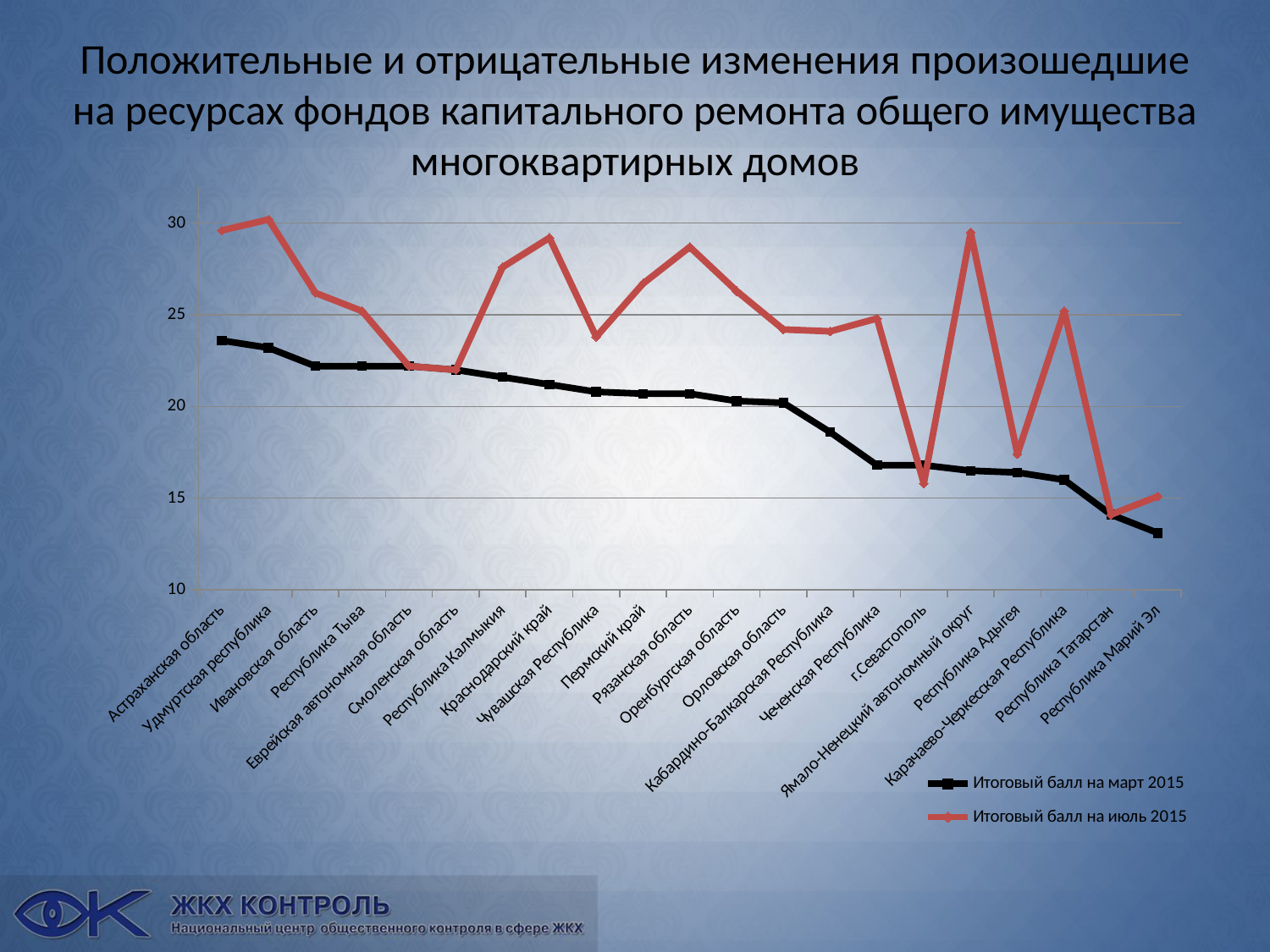
Is the value for Краснодарский край in the series "Итоговый балл на июль 2015" greater or less than 25? greater How many regions are plotted along the x axis? 21 Is the value for Чеченская Республика in the series "Итоговый балл на март 2015" greater or less than 20? less Does the series "Итоговый балл на март 2015" rise or fall from left to right along the x axis? fall Which region has the lowest value for "Итоговый балл на июль 2015"? Республика Татарстан What kind of chart is shown on the slide? line chart What colour is the line for "Итоговый балл на июль 2015"? red How many series does the legend list? 2 For Республика Марий Эл, which series has the larger value: "Итоговый балл на март 2015" or "Итоговый балл на июль 2015"? Итоговый балл на июль 2015 Is the value for г.Севастополь in the series "Итоговый балл на июль 2015" greater or less than 20? less Which region has the highest value for "Итоговый балл на март 2015"? Астраханская область Which region has the lowest value for "Итоговый балл на март 2015"? Республика Марий Эл